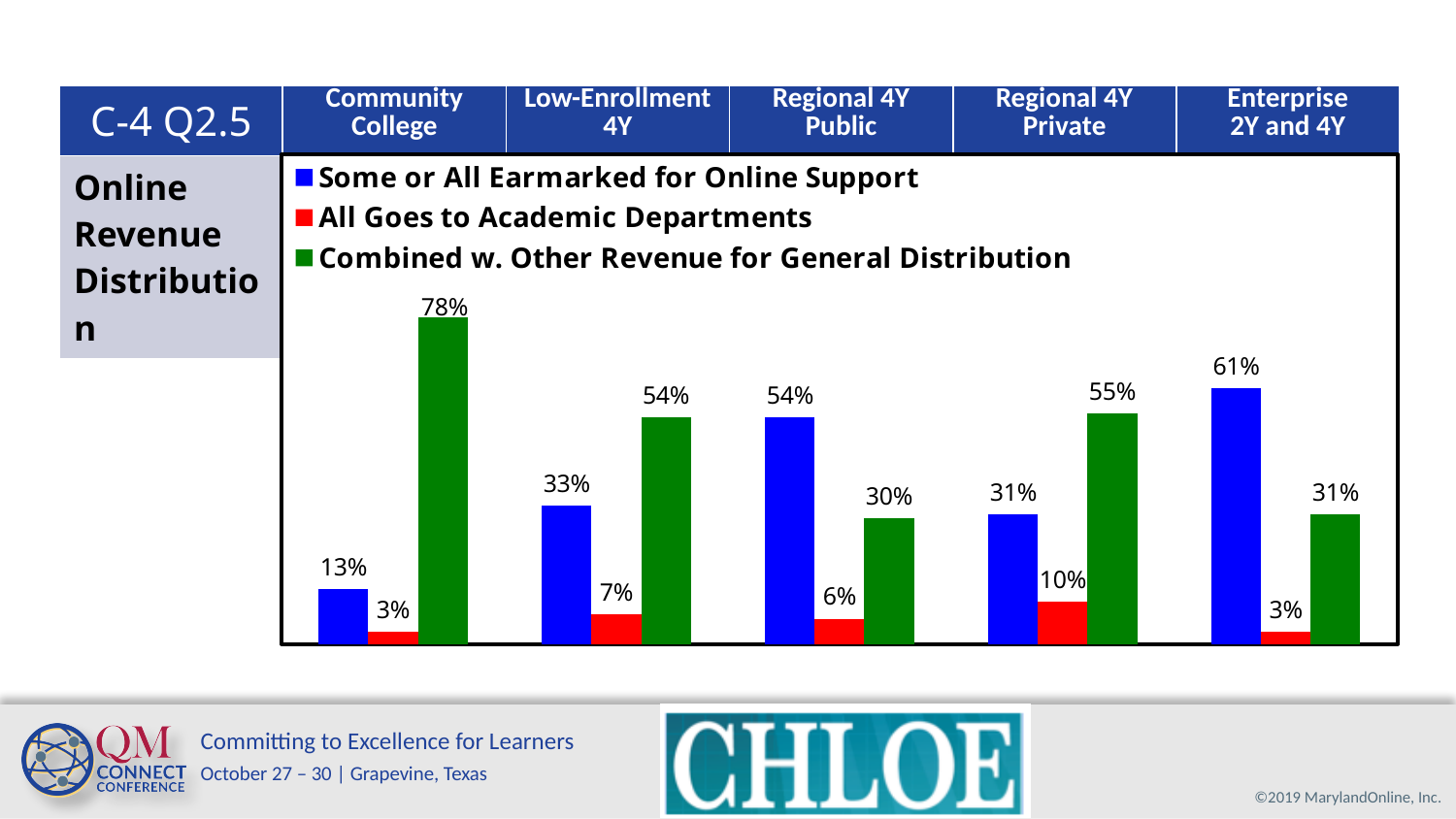
Which category has the highest value for 'All Goes to Academic Departments'? Regional 4Y Private What kind of chart is shown on the slide? bar chart Which category has the highest value for 'Some or All Earmarked for Online Support'? Enterprise 2Y and 4Y What colour are the bars for 'All Goes to Academic Departments'? red What is the value for 'Some or All Earmarked for Online Support' at Enterprise 2Y and 4Y? 61% What is the value for 'Combined w. Other Revenue for General Distribution' at Community College? 78% What is the difference between the 'Combined w. Other Revenue for General Distribution' value and the 'Some or All Earmarked for Online Support' value at Community College? 65% What is the value for 'All Goes to Academic Departments' at Regional 4Y Private? 10% How many institution categories are shown along the x axis? 5 At Regional 4Y Public, which is larger: 'Some or All Earmarked for Online Support' or 'Combined w. Other Revenue for General Distribution'? Some or All Earmarked for Online Support How many series does the legend list? 3 Which category has the lowest value for 'Combined w. Other Revenue for General Distribution'? Regional 4Y Public